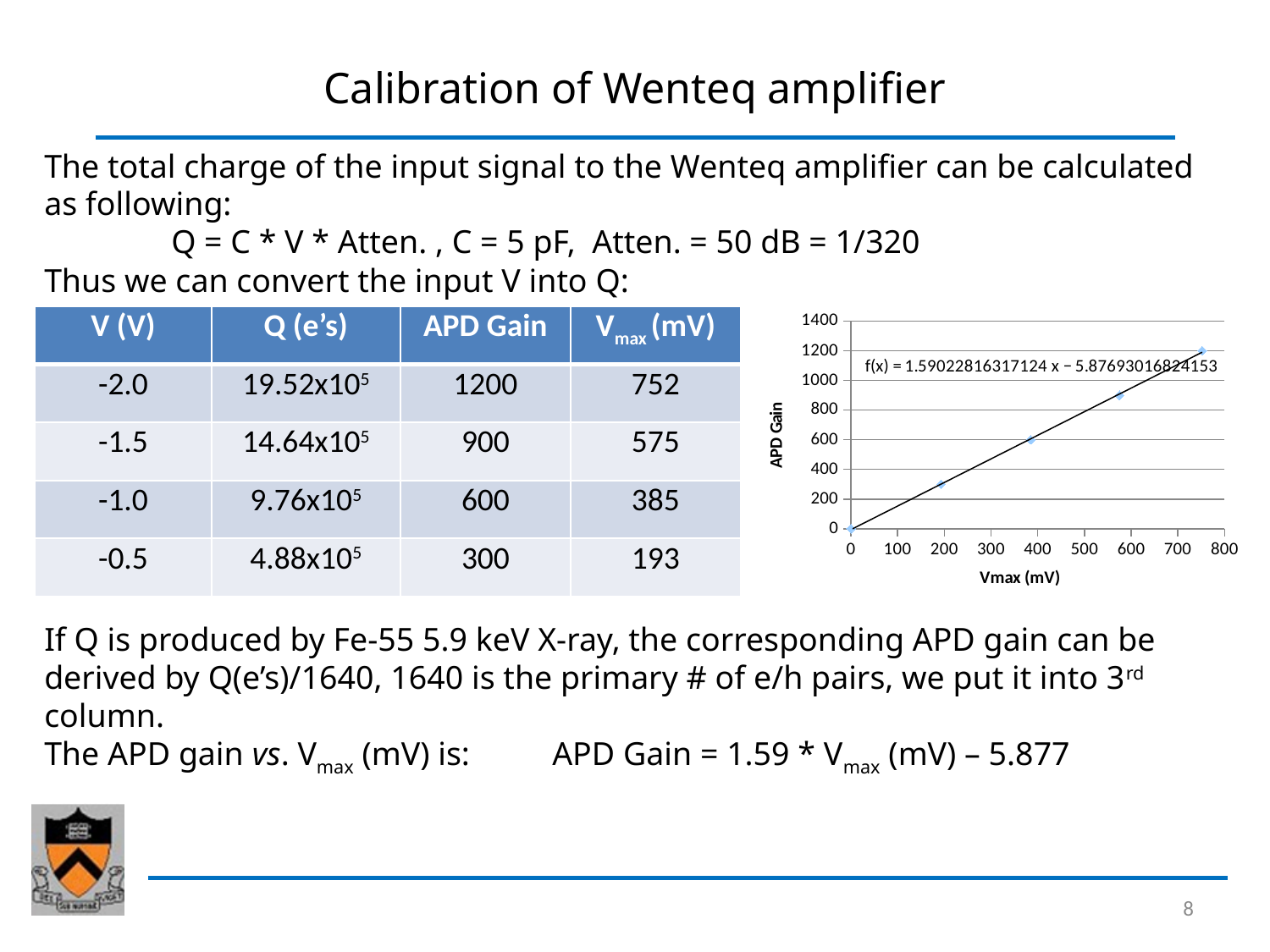
Does APD Gain rise or fall as Vmax (mV) increases along the x axis? rise Is the APD Gain for the data point near Vmax = 600 mV greater or less than 800? greater What is the APD Gain of the data point at Vmax = 0 mV? 0 What is the label of the y axis of the chart? APD Gain Is the Vmax of the rightmost data point greater or less than 700 mV? greater Which plotted point has the highest APD Gain: the one near Vmax = 750 mV or the one near Vmax = 600 mV? the one near Vmax = 750 mV Is the APD Gain for the data point near Vmax = 200 mV greater or less than 400? less What kind of chart is shown on the slide? scatter chart What is the label of the x axis of the chart? Vmax (mV) How many data points are plotted in the chart? 5 What is the maximum value shown on the y axis of the chart? 1400